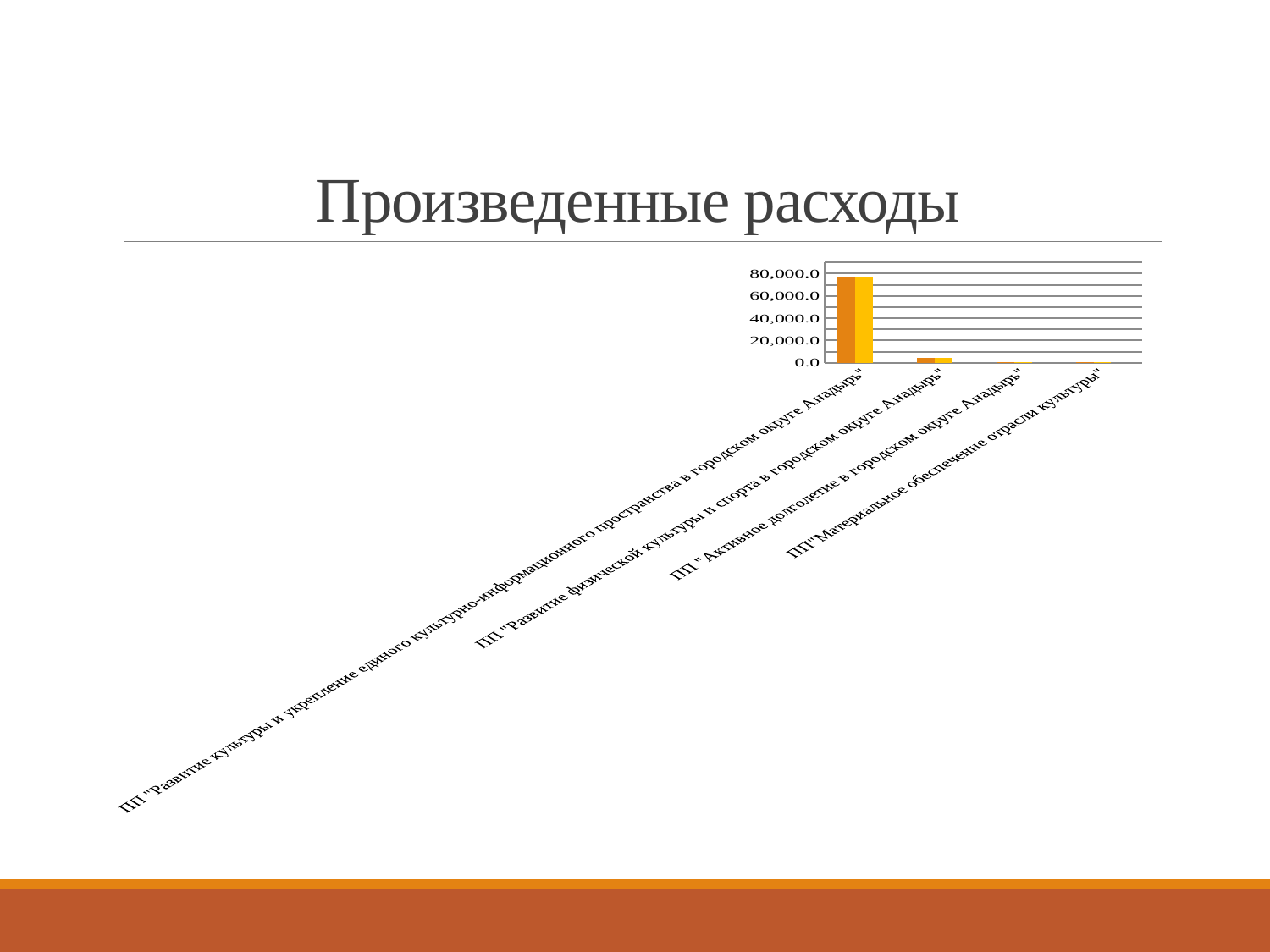
What is the highest value shown on the y axis of the chart? 80,000.0 Which category has the highest values in the chart? ПП "Развитие культуры и укрепление единого культурно-информационного пространства в городском округе Анадырь" Is the value for ПП "Активное долголетие в городском округе Анадырь" greater or less than 20,000.0? less Which has the larger value: ПП "Развитие культуры и укрепление единого культурно-информационного пространства в городском округе Анадырь" or ПП "Развитие физической культуры и спорта в городском округе Анадырь"? ПП "Развитие культуры и укрепление единого культурно-информационного пространства в городском округе Анадырь" How many categories are shown on the x axis of the chart? 4 Is the value for ПП "Развитие физической культуры и спорта в городском округе Анадырь" greater or less than 20,000.0? less Do the values rise or fall moving from left to right along the x axis? fall What kind of chart is shown on the slide? bar chart What is the title of the chart on the slide? Произведенные расходы Which has the larger value: ПП "Развитие физической культуры и спорта в городском округе Анадырь" or ПП"Материальное обеспечение отрасли культуры"? ПП "Развитие физической культуры и спорта в городском округе Анадырь" Is the value for ПП "Развитие культуры и укрепление единого культурно-информационного пространства в городском округе Анадырь" greater or less than 60,000.0? greater